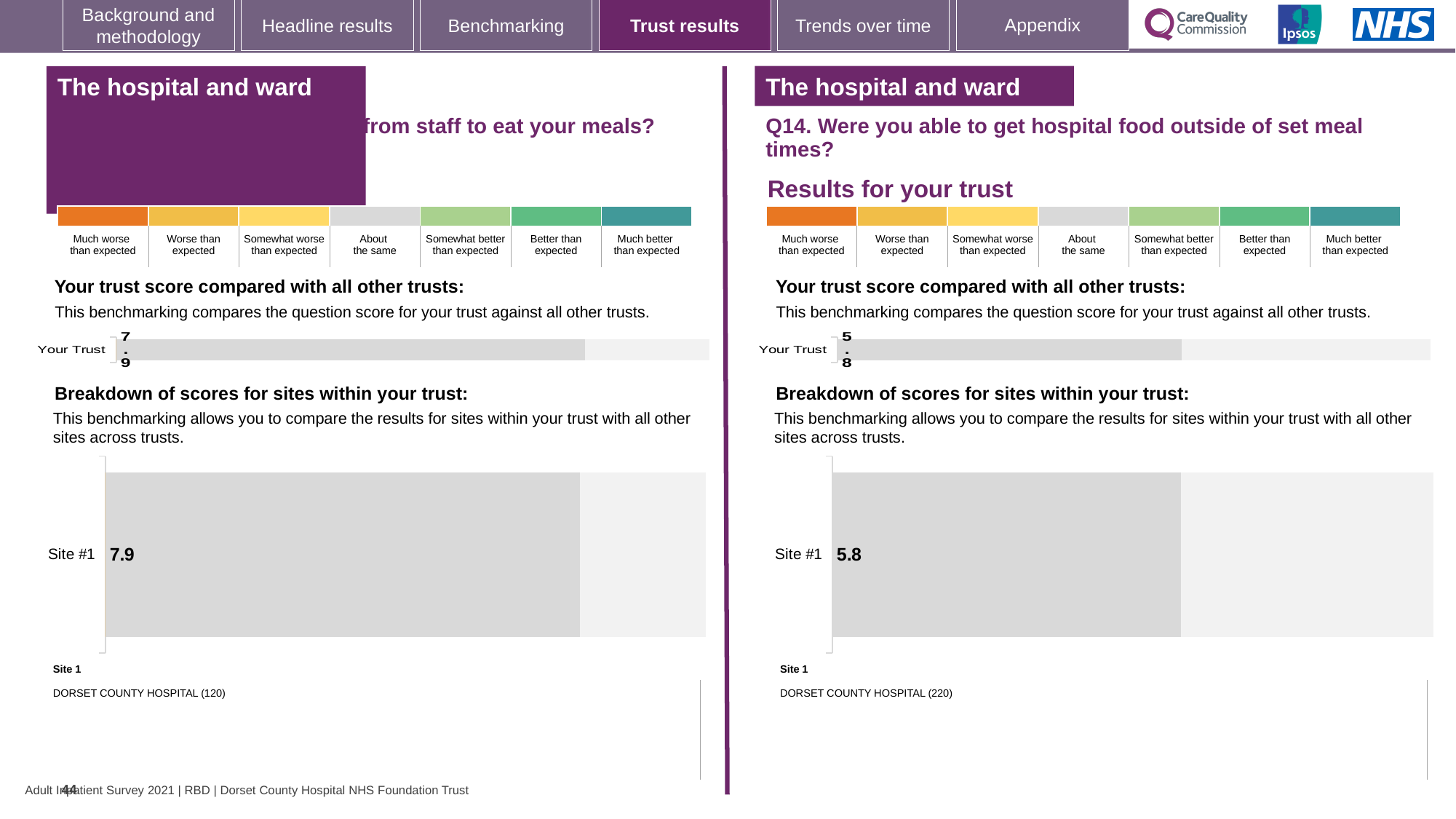
How many sites are shown in the right 'Breakdown of scores for sites within your trust' chart (Q14)? 1 On the left half of the slide, what is the value shown for Your Trust in the 'Your trust score compared with all other trusts' chart? 7.9 Which site name is listed under Site 1 in the right half of the slide (Q14)? DORSET COUNTY HOSPITAL (220) On the right half of the slide (Q14), what is the value shown for Your Trust in the 'Your trust score compared with all other trusts' chart? 5.8 In the left 'Breakdown of scores for sites within your trust' chart, what is the score for Site #1? 7.9 What kind of chart is used for the 'Breakdown of scores for sites within your trust' on the right half of the slide? Bar chart In the right 'Breakdown of scores for sites within your trust' chart (Q14), what is the score for Site #1? 5.8 How many sites are shown in the left 'Breakdown of scores for sites within your trust' chart? 1 Which site name is listed under Site 1 in the left half of the slide? DORSET COUNTY HOSPITAL (120) What kind of chart is used to show the Your Trust score on the left half of the slide? Bar chart Which is larger: the Site #1 score in the left breakdown chart or the Site #1 score in the right breakdown chart (Q14)? The left chart (7.9) What is the difference between the Your Trust score on the left half of the slide and the Your Trust score on the right half (Q14)? 2.1